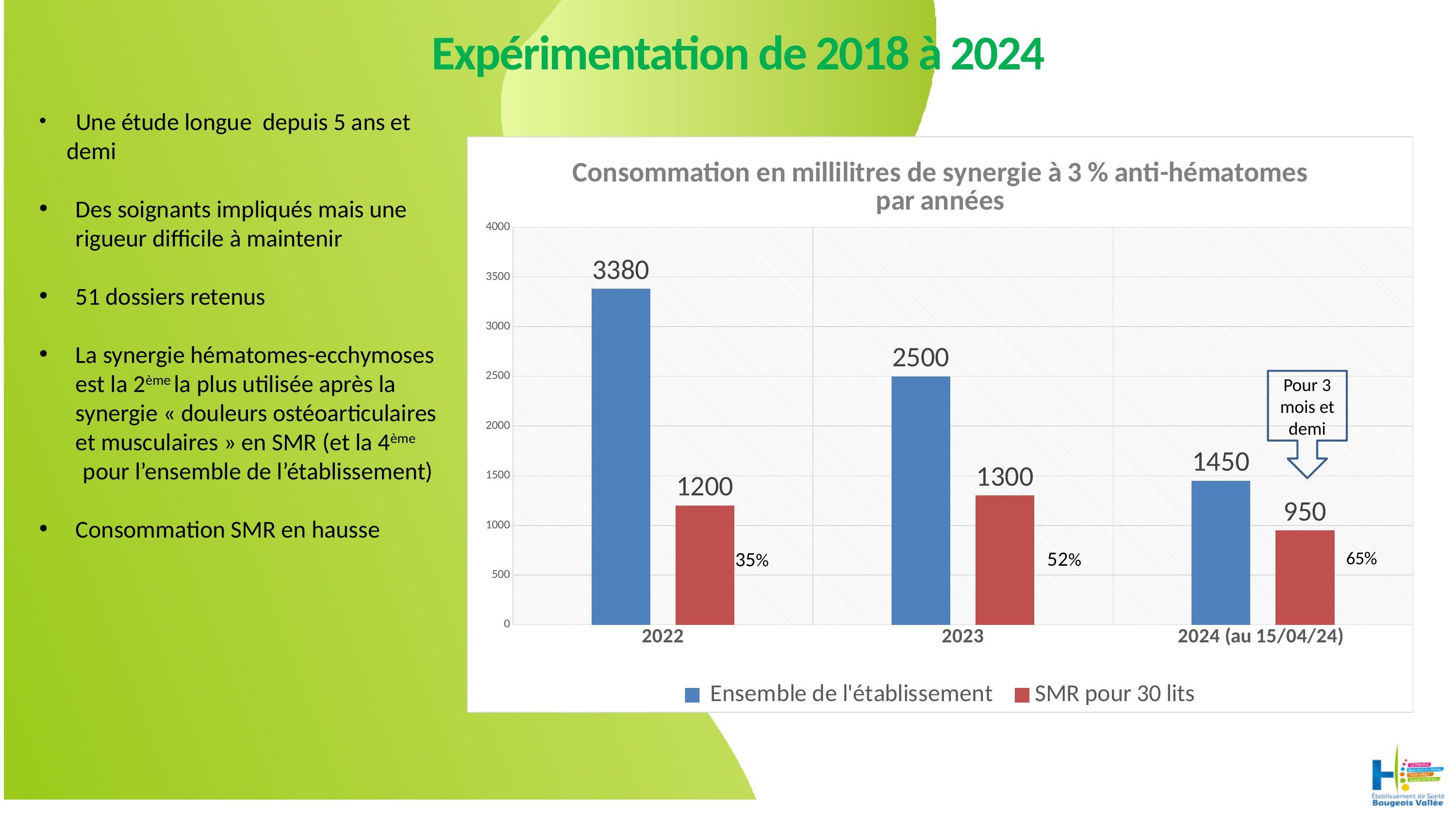
Does the value for Ensemble de l'établissement rise or fall from 2022 to 2024 (au 15/04/24)? fall How many year categories are shown on the x axis? 3 Which is larger in 2022: Ensemble de l'établissement or SMR pour 30 lits? Ensemble de l'établissement Which year has the highest value for Ensemble de l'établissement? 2022 What kind of chart is shown? bar chart What is the value for SMR pour 30 lits in 2023? 1300 What is the value for Ensemble de l'établissement in 2022? 3380 How many series does the legend list? 2 What is the difference between Ensemble de l'établissement and SMR pour 30 lits in 2023? 1200 Which year has the lowest value for SMR pour 30 lits? 2024 (au 15/04/24) What is the value for SMR pour 30 lits in 2024 (au 15/04/24)? 950 Is the value for Ensemble de l'établissement in 2024 (au 15/04/24) greater or less than 1500? less